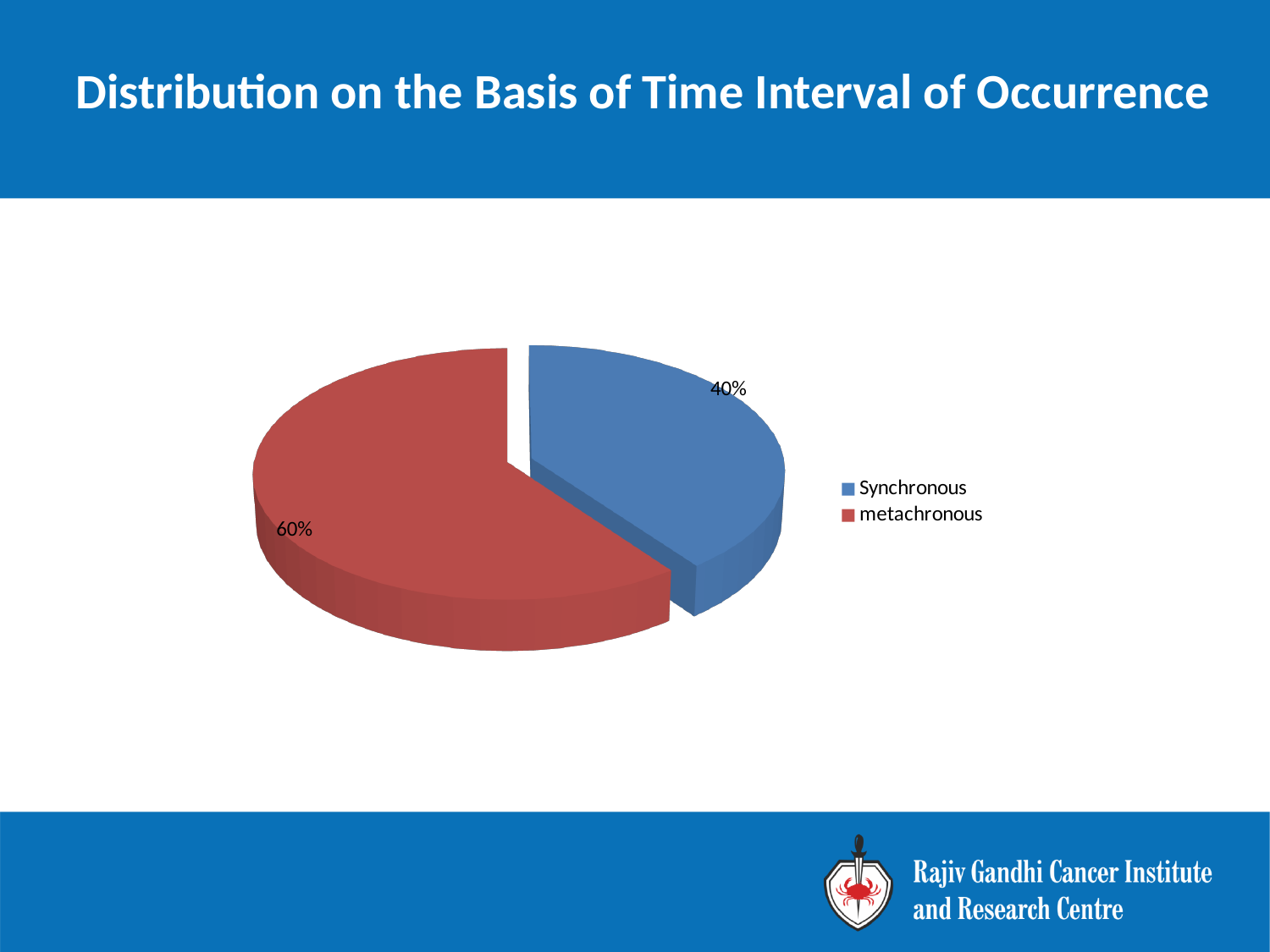
What colour is the metachronous slice? Red What share of the pie does Synchronous represent? 40% Which category has the smallest slice of the pie? Synchronous What is the title of the slide containing the chart? Distribution on the Basis of Time Interval of Occurrence What is the difference in percentage points between the metachronous and Synchronous slices? 20% Which category has the largest slice of the pie? metachronous What kind of chart is shown on the slide? Pie chart How many categories are shown in the pie chart? 2 What share of the pie does metachronous represent? 60% How many entries does the legend list? 2 Which is larger, the Synchronous slice or the metachronous slice? metachronous